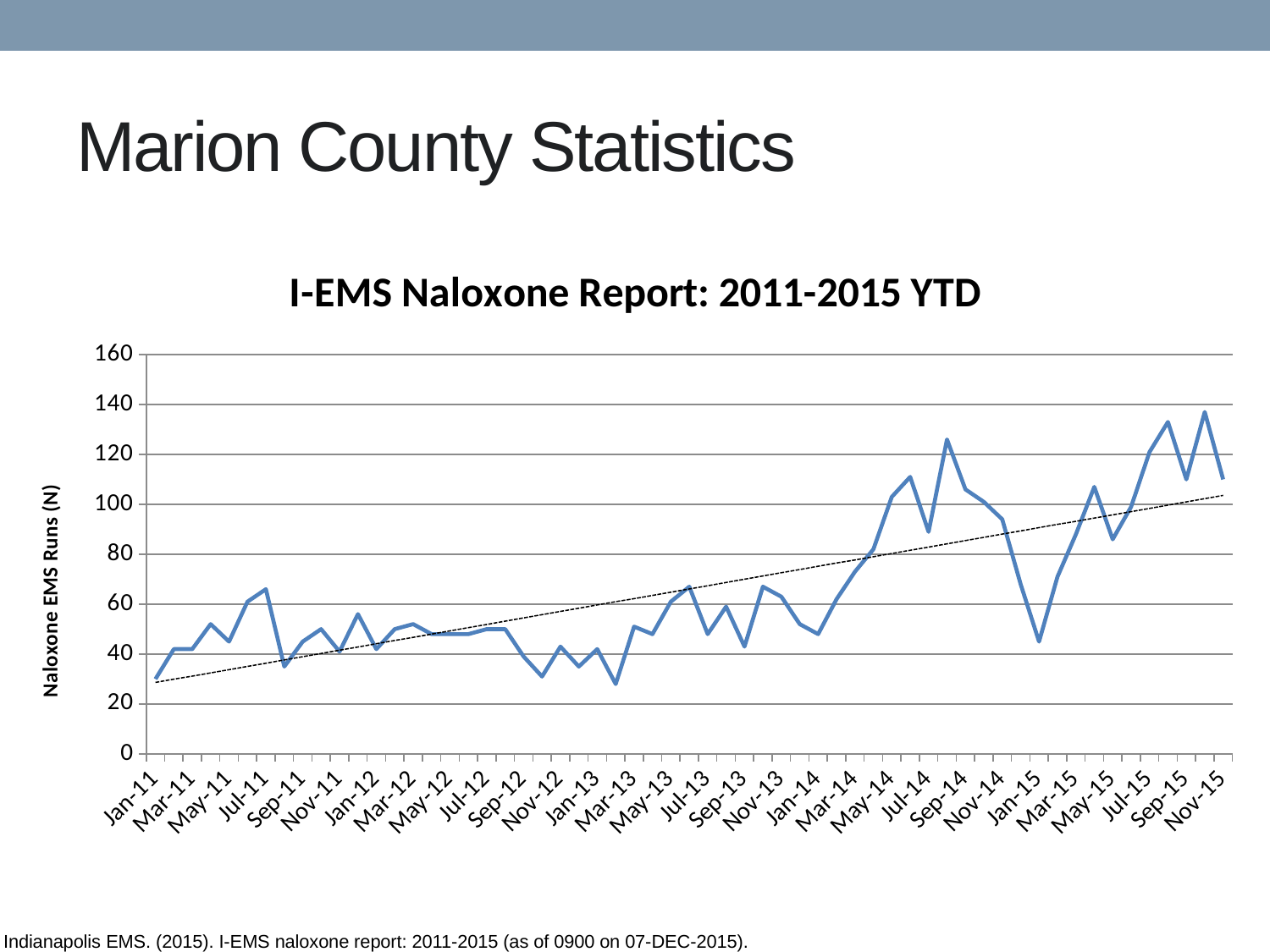
Is the value for Jan-15 greater or less than 60? less Overall, do the naloxone EMS runs rise or fall from Jan-11 to Nov-15? rise Is the value for Mar-13 greater or less than 40? greater What is the label on the vertical axis of the chart? Naloxone EMS Runs (N) Is the value for Sep-14 greater or less than 120? less What kind of chart is shown on the slide? line chart What is the title of the chart? I-EMS Naloxone Report: 2011-2015 YTD